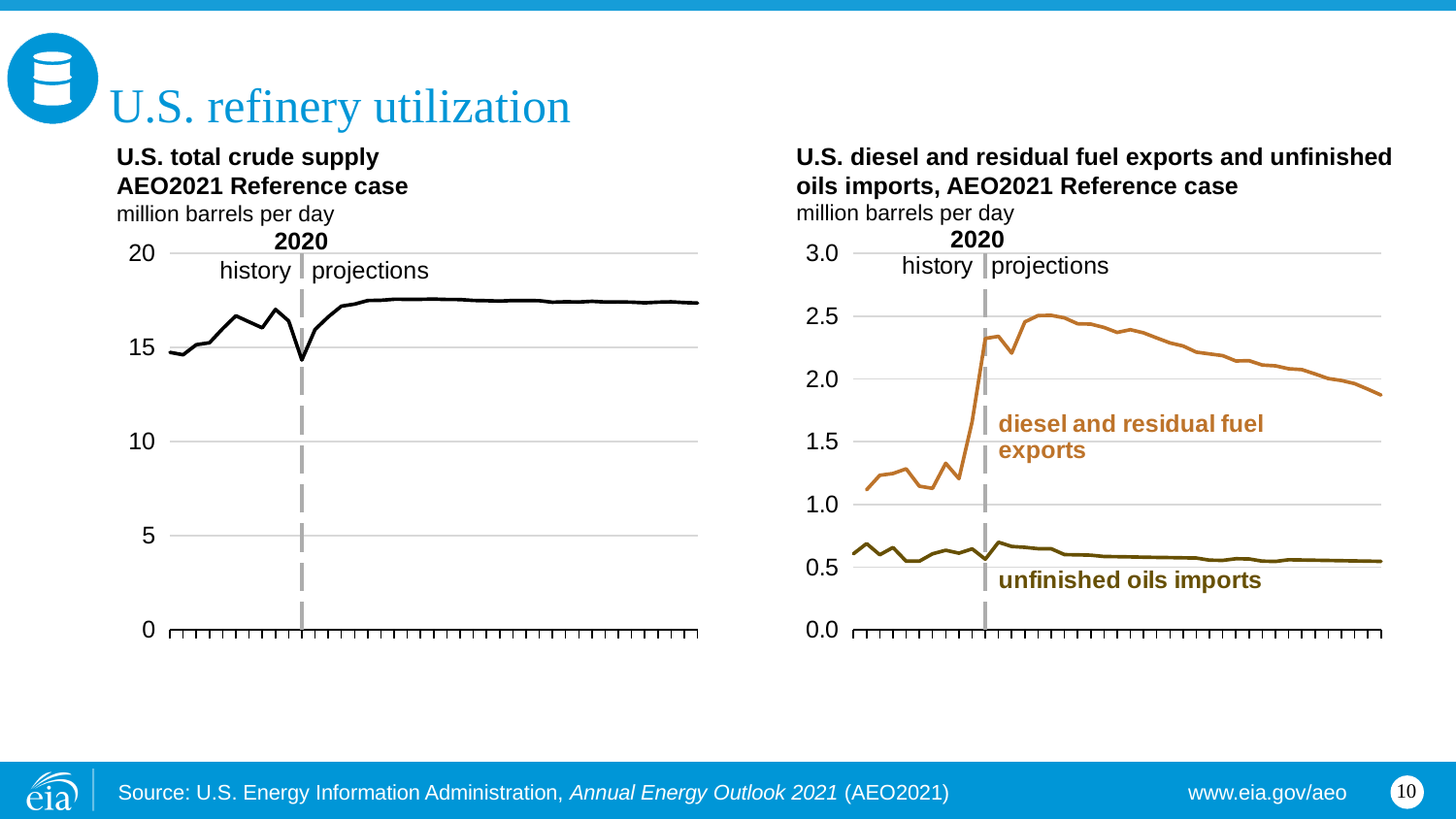
In the right chart, is the value for diesel and residual fuel exports at the end of the projection period greater or less than 1.5? greater In the left chart, is the value for U.S. total crude supply in 2020 greater or less than 15? less In the left chart, is the value for U.S. total crude supply at the end of the projection period greater or less than 15? greater In the right chart, do diesel and residual fuel exports rise or fall over the projection period after their peak? fall Which year marks the boundary between history and projections in both charts? 2020 What unit is used on the y axis of both charts? million barrels per day What kind of chart is the left chart, 'U.S. total crude supply'? line chart What kind of chart is the right chart, 'U.S. diesel and residual fuel exports and unfinished oils imports'? line chart In the right chart, how many series are plotted? 2 In the right chart, which series has higher values throughout: diesel and residual fuel exports or unfinished oils imports? diesel and residual fuel exports